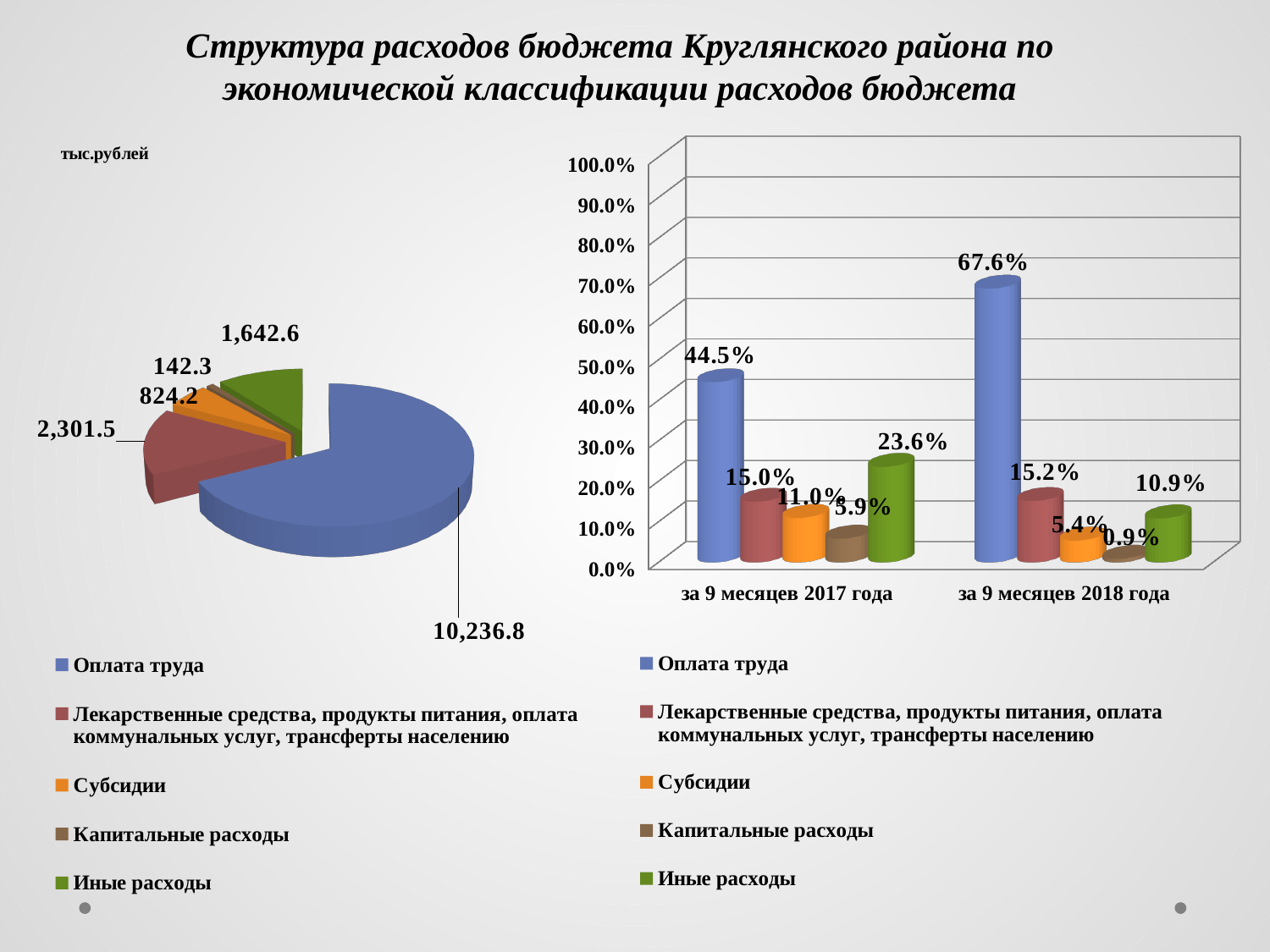
On the left pie chart, which category has the smallest value? Капитальные расходы On the right bar chart, what is the value for Иные расходы за 9 месяцев 2017 года? 23.6% On the left pie chart, what is the value for Оплата труда? 10,236.8 What type of chart is on the left side of the slide? Pie chart On the left pie chart, what is the difference between Лекарственные средства, продукты питания, оплата коммунальных услуг, трансферты населению and Иные расходы? 658.9 On the right bar chart, how many series does the legend list? 5 On the right bar chart, what is the difference in Оплата труда between за 9 месяцев 2018 года and за 9 месяцев 2017 года? 23.1% On the left pie chart, how many slices are there? 5 On the left pie chart, what is the value for Капитальные расходы? 142.3 On the right bar chart, which is larger: Субсидии за 9 месяцев 2017 года or Субсидии за 9 месяцев 2018 года? Субсидии за 9 месяцев 2017 года On the right bar chart, what is the value for Оплата труда за 9 месяцев 2018 года? 67.6% What unit is shown above the left pie chart? тыс.рублей